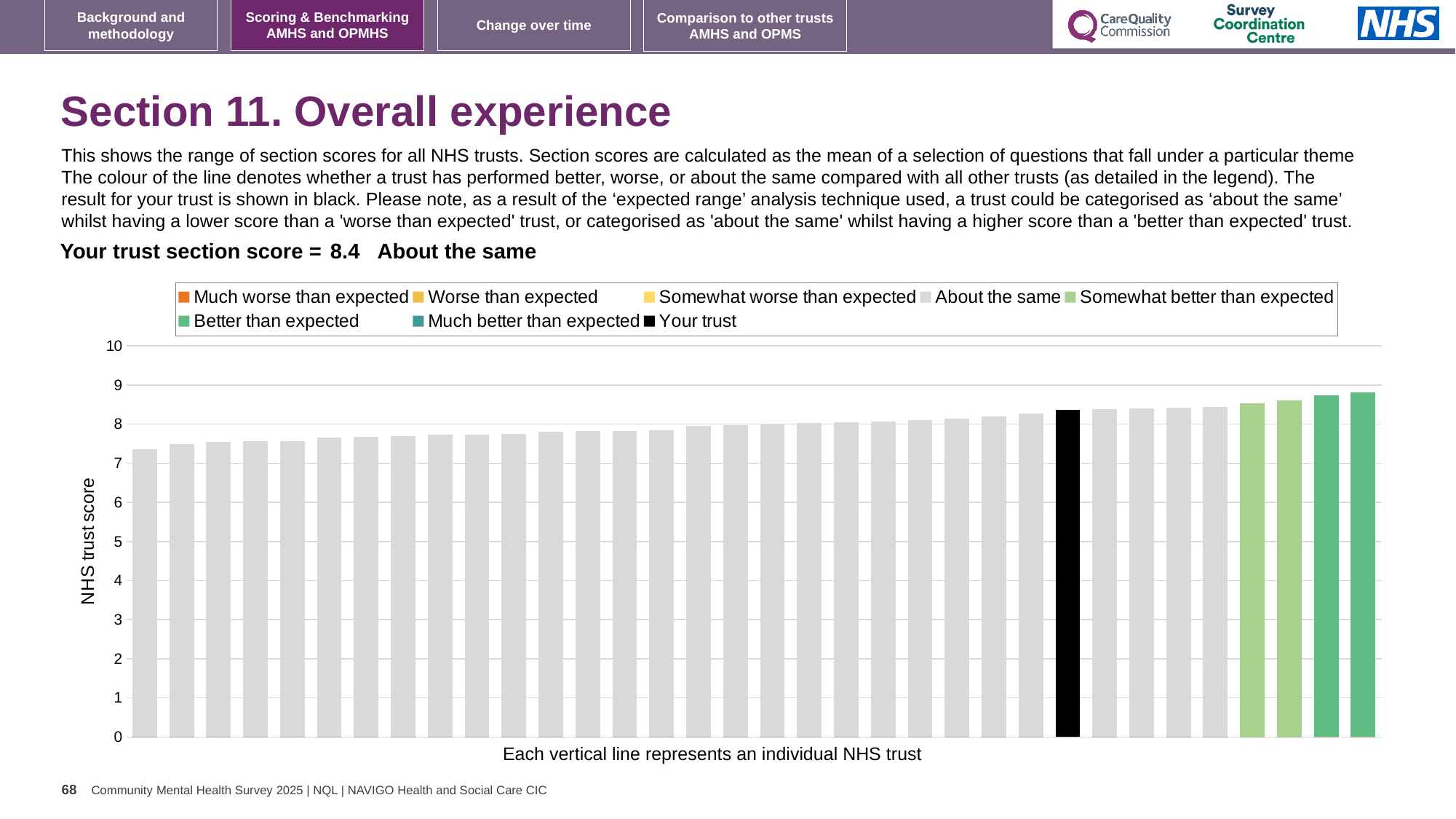
What kind of chart is shown on the slide? Bar chart What is the label on the vertical axis of the chart? NHS trust score Is the black 'Your trust' bar higher or lower than the leftmost bar? higher Is the value of the rightmost (highest) bar greater or less than 9? less Do the bar values rise or fall from left to right along the x axis? rise How many bars are coloured in the 'Better than expected' (darker green) colour? 2 Is the value of the leftmost (lowest) bar greater or less than 8? less What is the section score for your trust shown on the slide? 8.4 How many entries does the chart legend list? 8 Which performance category is your trust placed in according to the slide? About the same Is the black 'Your trust' bar higher or lower than the rightmost bar? lower Is the value of the black 'Your trust' bar greater or less than 8? greater